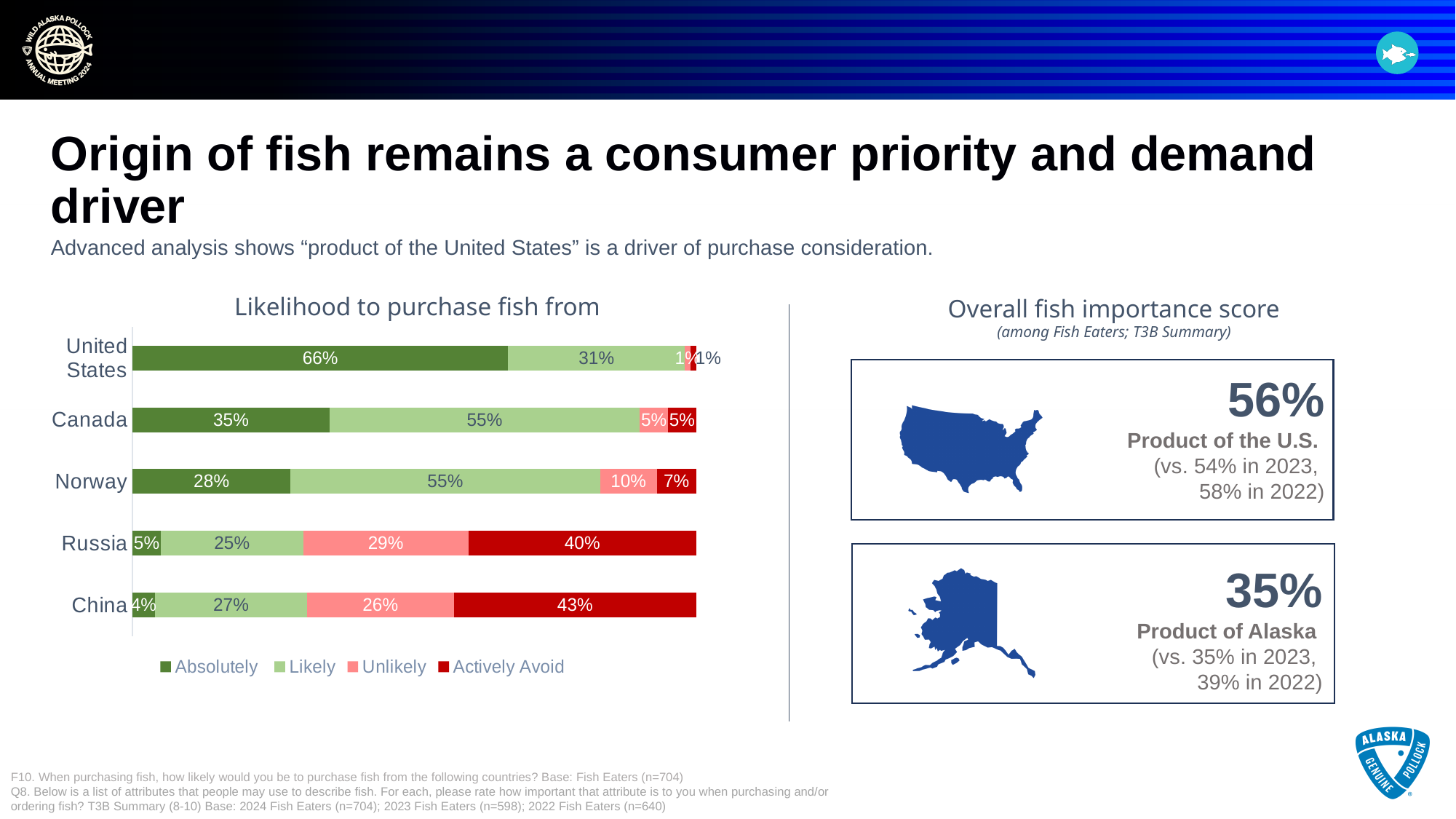
What is the "Unlikely" value for Norway? 10% What is the title of the chart? Likelihood to purchase fish from What is the "Actively Avoid" value for China? 43% What is the difference between the "Actively Avoid" values for China and Russia? 3% How many countries are shown in the chart? 5 What is the combined "Absolutely" and "Likely" value for Canada? 90% How many series does the legend list? 4 What kind of chart is used to show likelihood to purchase fish from each country? Stacked bar chart Which is larger, the "Likely" value for Canada or the "Likely" value for Russia? Canada Which country has the highest "Absolutely" value? United States Which country has the lowest "Absolutely" value? China What percentage of respondents said they would "Absolutely" purchase fish from the United States? 66%